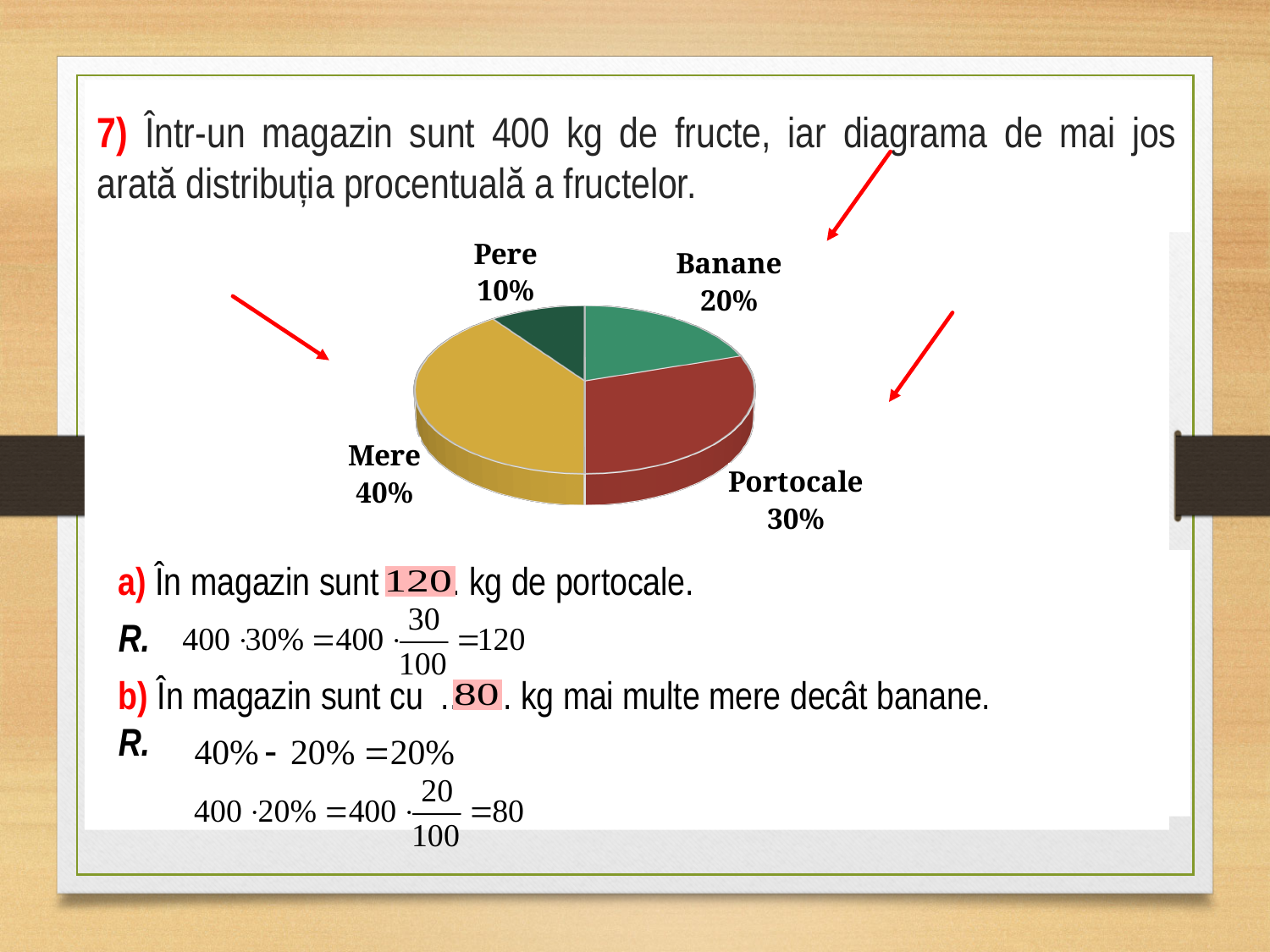
What is the difference in percentage points between Mere and Banane? 20% Which fruit has the largest share of the pie? Mere What percentage of the fruit is Portocale (oranges)? 30% Which has a larger share, Portocale or Banane? Portocale What percentage of the fruit is Mere (apples)? 40% What kind of chart is shown on the slide? pie chart What percentage of the fruit is Pere (pears)? 10% How many slices does the pie chart have? 4 What colour is the Mere slice of the pie chart? yellow What percentage of the fruit is Banane (bananas)? 20% Which fruit has the smallest share of the pie? Pere What is the combined share of Pere and Banane? 30%